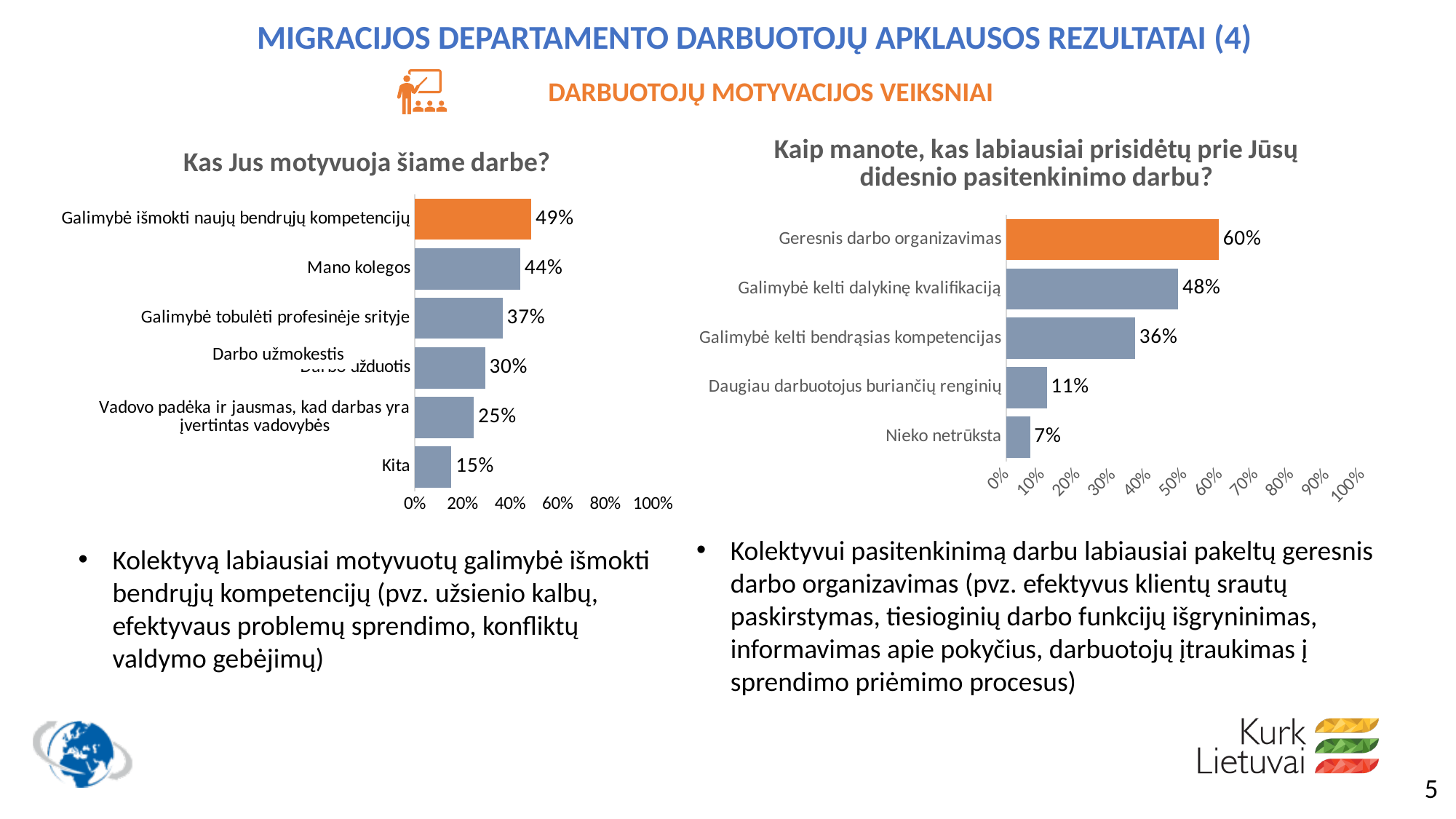
In the chart 'Kas Jus motyvuoja šiame darbe?', what is the value for 'Mano kolegos'? 44% In the chart 'Kas Jus motyvuoja šiame darbe?', which category has the lowest value? Kita In the chart 'Kaip manote, kas labiausiai prisidėtų prie Jūsų didesnio pasitenkinimo darbu?', what is the value for 'Geresnis darbo organizavimas'? 60% In the chart 'Kaip manote, kas labiausiai prisidėtų prie Jūsų didesnio pasitenkinimo darbu?', which is larger: 'Galimybė kelti dalykinę kvalifikaciją' or 'Galimybė kelti bendrąsias kompetencijas'? Galimybė kelti dalykinę kvalifikaciją In the chart 'Kaip manote, kas labiausiai prisidėtų prie Jūsų didesnio pasitenkinimo darbu?', how many categories are shown? 5 In the chart 'Kas Jus motyvuoja šiame darbe?', what is the difference between 'Galimybė išmokti naujų bendrųjų kompetencijų' and 'Galimybė tobulėti profesinėje srityje'? 12% In the chart 'Kas Jus motyvuoja šiame darbe?', how many bars are plotted? 6 In the chart 'Kas Jus motyvuoja šiame darbe?', which category has the highest value? Galimybė išmokti naujų bendrųjų kompetencijų In the chart 'Kas Jus motyvuoja šiame darbe?', which bar is coloured orange? Galimybė išmokti naujų bendrųjų kompetencijų What type of chart is 'Kaip manote, kas labiausiai prisidėtų prie Jūsų didesnio pasitenkinimo darbu?'? Bar chart In the chart 'Kaip manote, kas labiausiai prisidėtų prie Jūsų didesnio pasitenkinimo darbu?', what is the difference between 'Geresnis darbo organizavimas' and 'Daugiau darbuotojus buriančių renginių'? 49% In the chart 'Kaip manote, kas labiausiai prisidėtų prie Jūsų didesnio pasitenkinimo darbu?', what is the value for 'Nieko netrūksta'? 7%